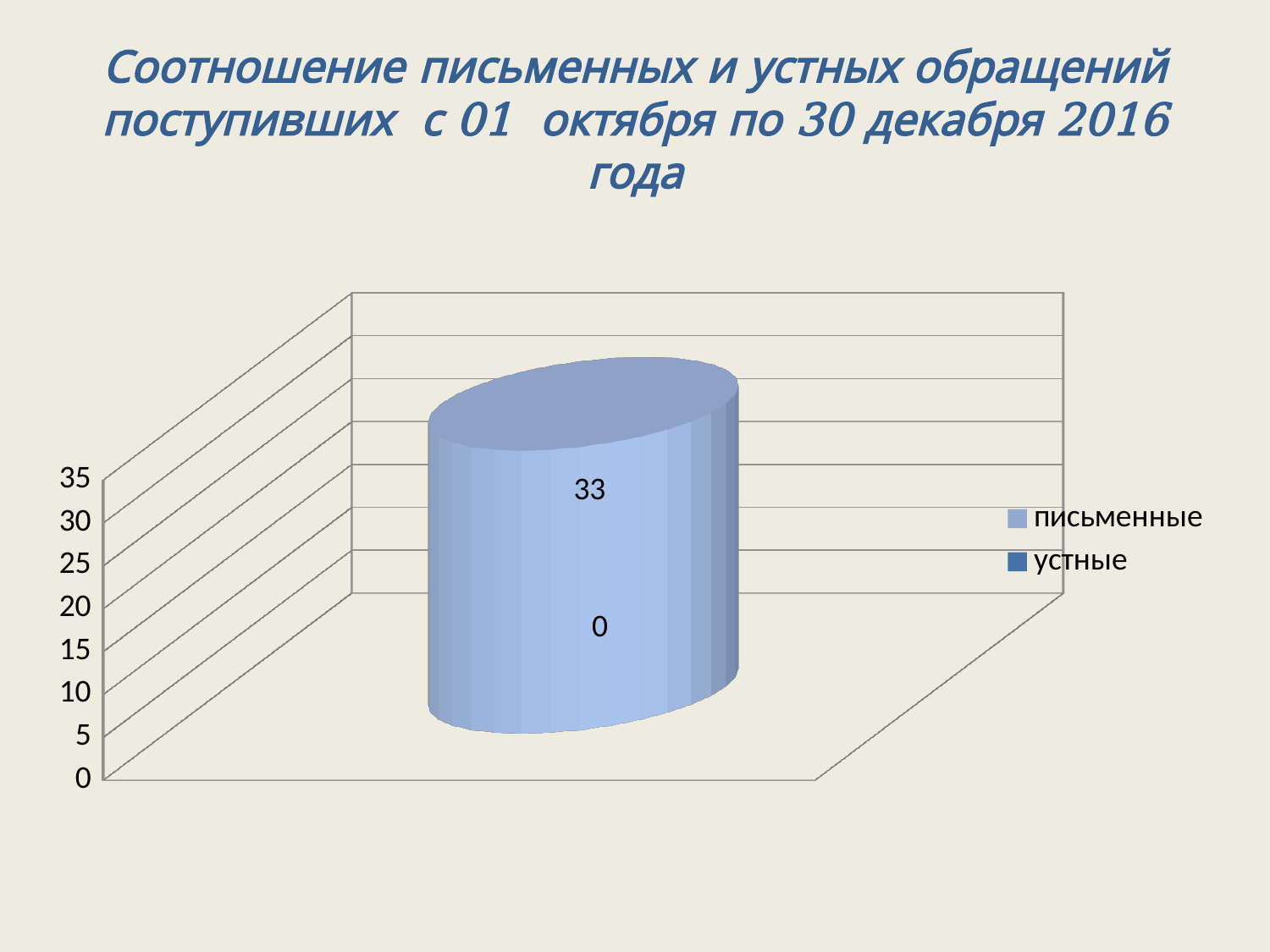
How many series does the legend list? 2 What is the difference between the values for письменные and устные? 33 Which series has the lowest value? устные What is the value for устные? 0 Which series has the highest value? письменные What is the value for письменные? 33 What is the total of the values for письменные and устные? 33 Is the value for письменные greater or less than 30? greater Which series has the higher value, письменные or устные? письменные What is the title of the chart on the slide? Соотношение письменных и устных обращений поступивших с 01 октября по 30 декабря 2016 года What kind of chart is shown on the slide? bar chart What is the maximum value shown on the vertical axis? 35